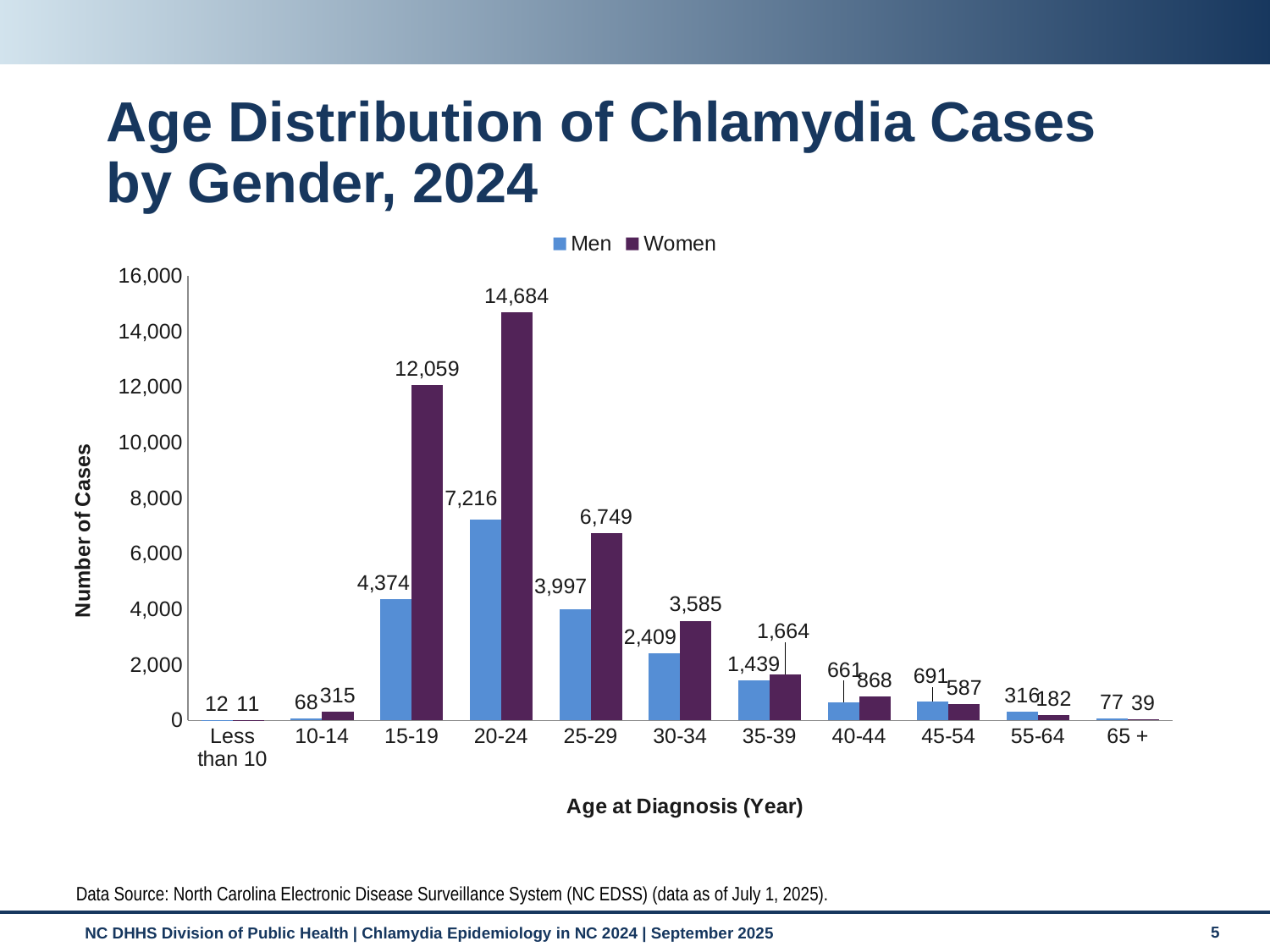
What is the number of chlamydia cases for Men in the 15-19 age group? 4,374 What is the number of chlamydia cases for Women in the 20-24 age group? 14,684 In the 15-19 age group, what is the difference between the number of cases for Women and for Men? 7,685 What is the title of the x axis? Age at Diagnosis (Year) Which age group has the lowest number of cases for Men? Less than 10 What is the number of cases for Women in the 30-34 age group? 3,585 How many age groups are shown on the x axis? 11 How many series does the legend list? 2 What kind of chart is shown on the slide? Bar chart In the 20-24 age group, how many more cases are there for Women than for Men? 7,468 Which age group has the highest number of cases for Women? 20-24 In the 45-54 age group, which series has more cases, Men or Women? Men